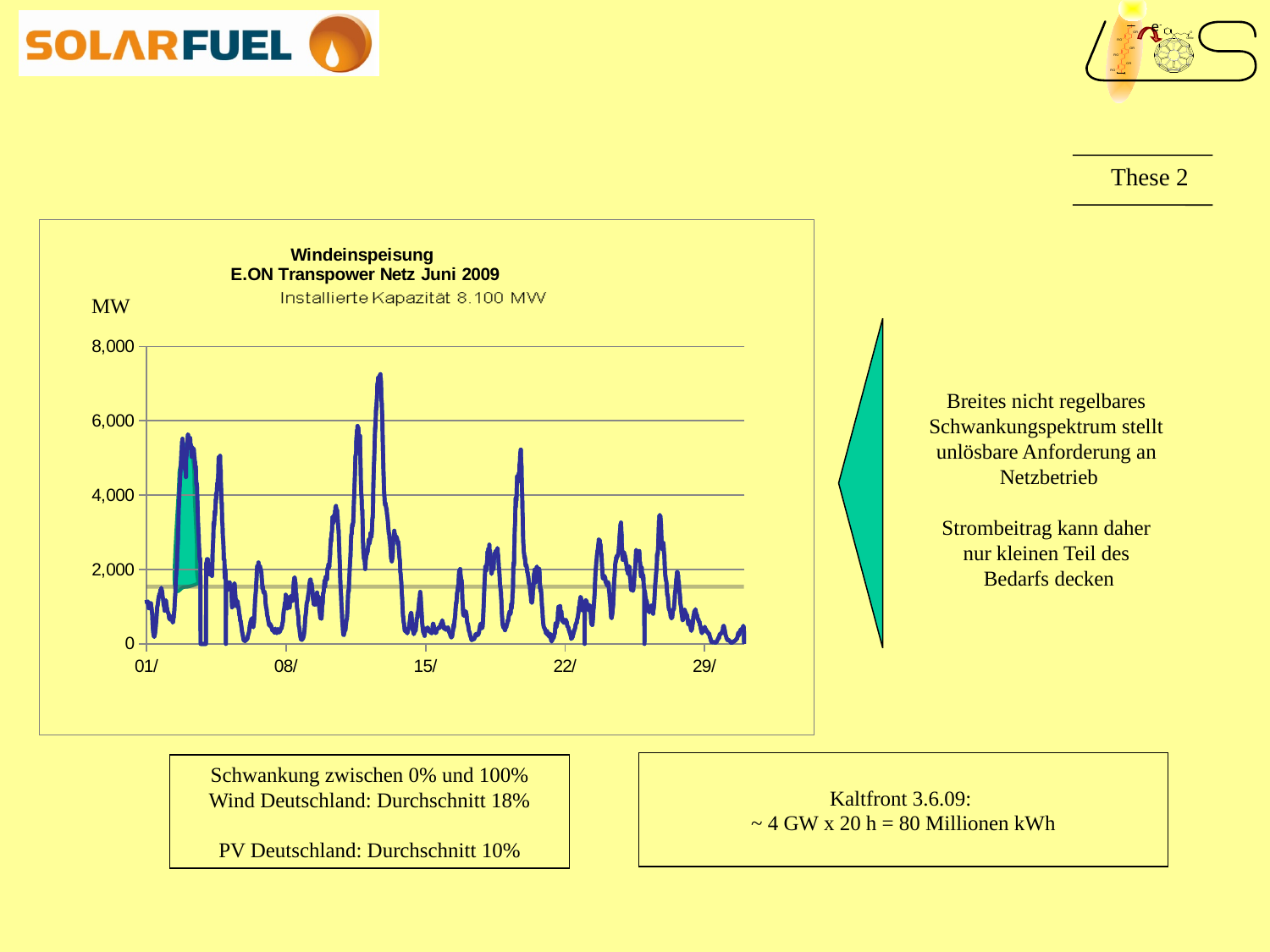
Does the wind feed-in line ever reach the 8,000 MW gridline? no What is the title of the chart? Windeinspeisung E.ON Transpower Netz Juni 2009 What unit is shown on the y axis of the chart? MW Between which two x-axis labels does the highest peak of the line occur? 08/ and 15/ What installed capacity is stated in the chart subtitle? 8.100 MW Is the value at 15/ greater or less than 2,000 MW? less Is the value at 01/ greater or less than 2,000 MW? less How many date labels are shown on the x axis of the chart? 5 What kind of chart is shown on the slide? line chart What is the highest tick value on the y axis of the chart? 8,000